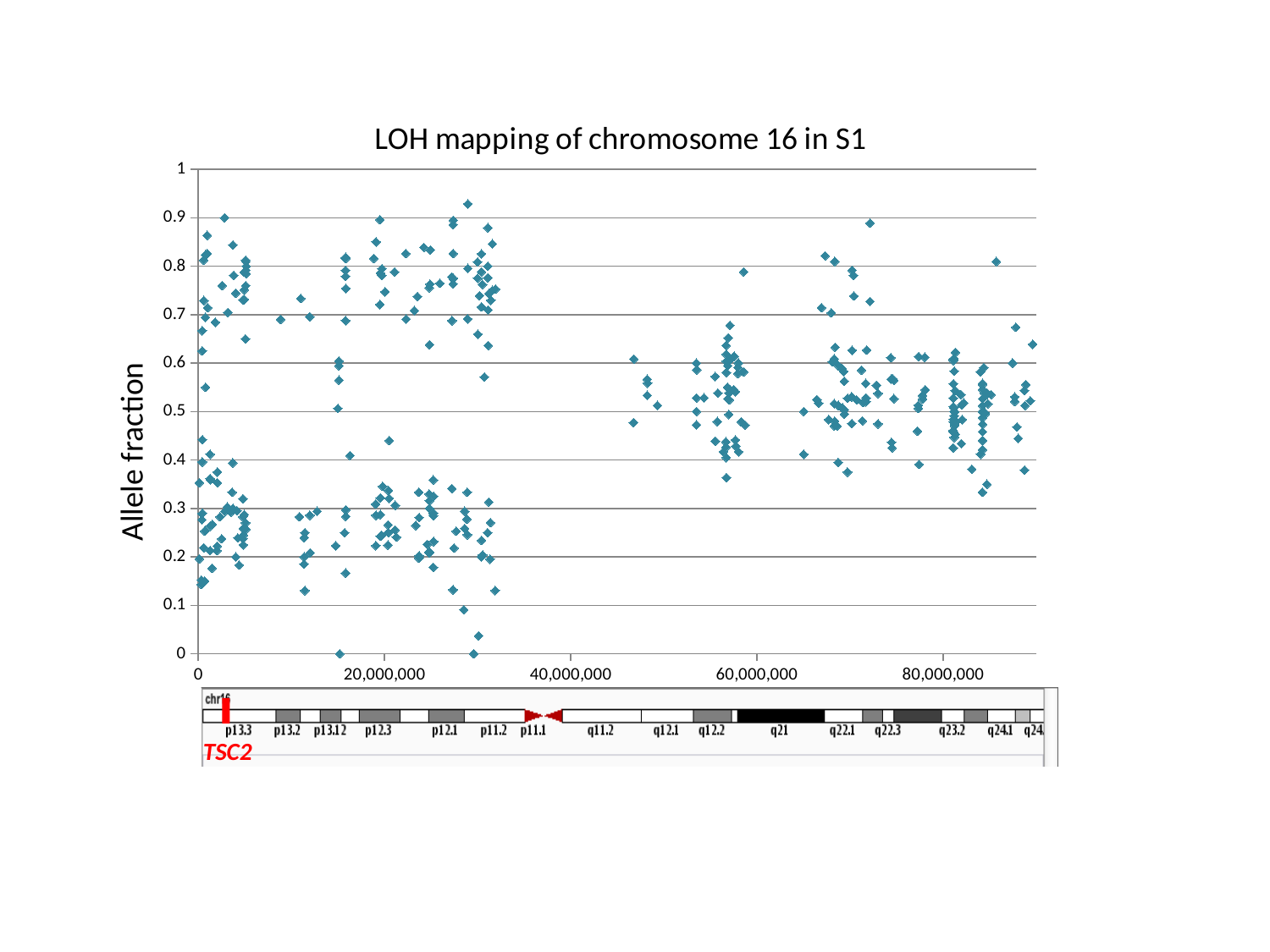
What is the maximum value shown on the y axis? 1 Are any points plotted between 35,000,000 and 45,000,000 on the x axis? No What is the title of the chart? LOH mapping of chromosome 16 in S1 Is the highest point plotted beyond 60,000,000 on the x axis greater or less than 0.8? greater What is the largest tick label shown on the x axis? 80,000,000 What is the label on the y axis of the chart? Allele fraction What kind of chart is shown on the slide? Scatter plot